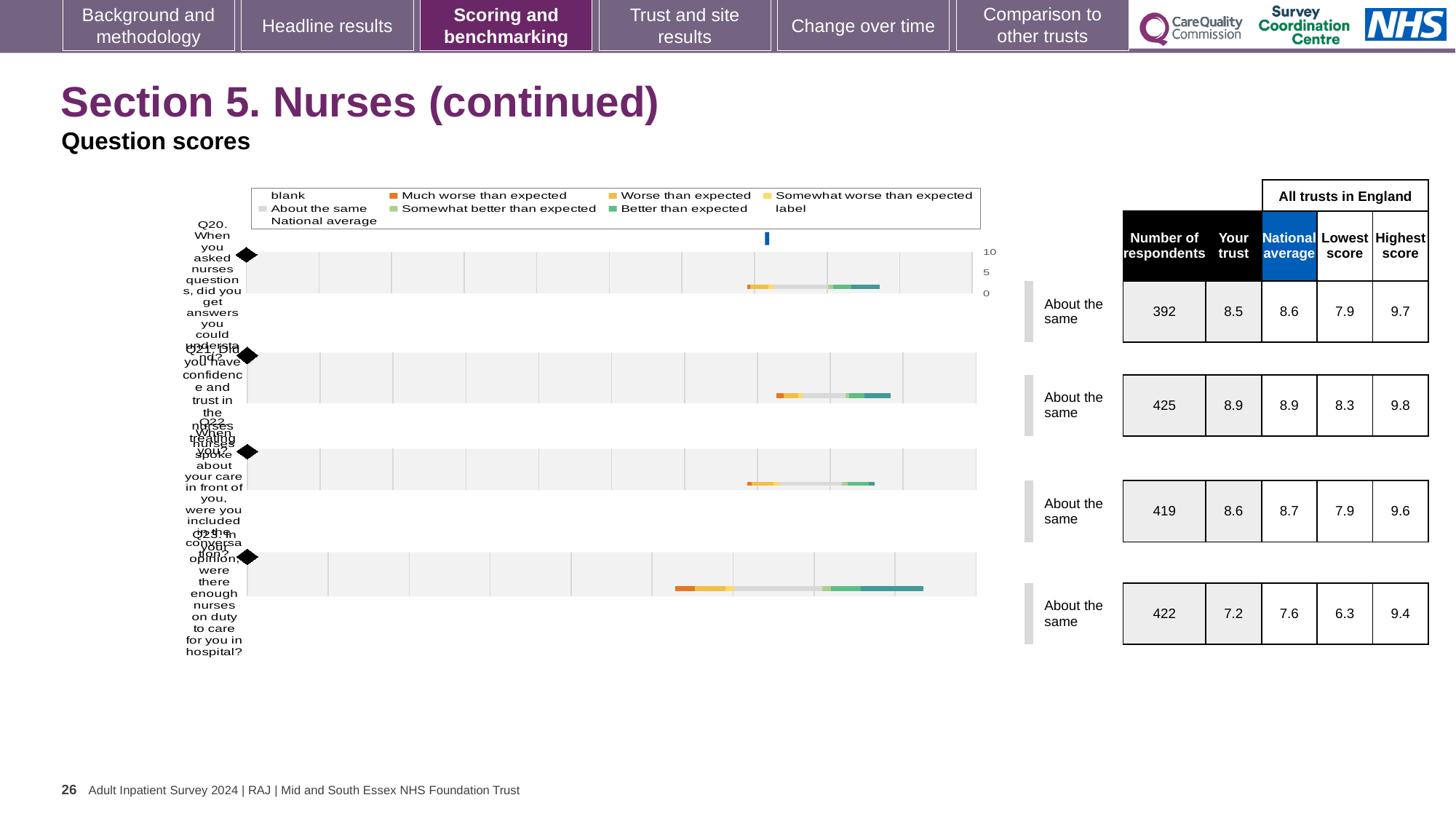
What is the lowest score among all trusts in England for Q23? 6.3 What is the 'Your trust' score for Q23 (were there enough nurses on duty)? 7.2 Which question has the highest 'Your trust' score? Q21 What is the difference between the highest score and the lowest score for Q23? 3.1 How many respondents are listed for Q21 (confidence and trust in nurses)? 425 Which question has the lowest 'Your trust' score? Q23 What kind of chart is used to show the question scores on this slide? bar chart For Q20, which is larger: the 'Your trust' score or the national average? National average What benchmark category is shown for all four questions on this slide? About the same What colour does the legend use for 'Much worse than expected'? Orange How many questions (rows) are plotted in the chart? 4 What is the highest score among all trusts in England for Q21? 9.8